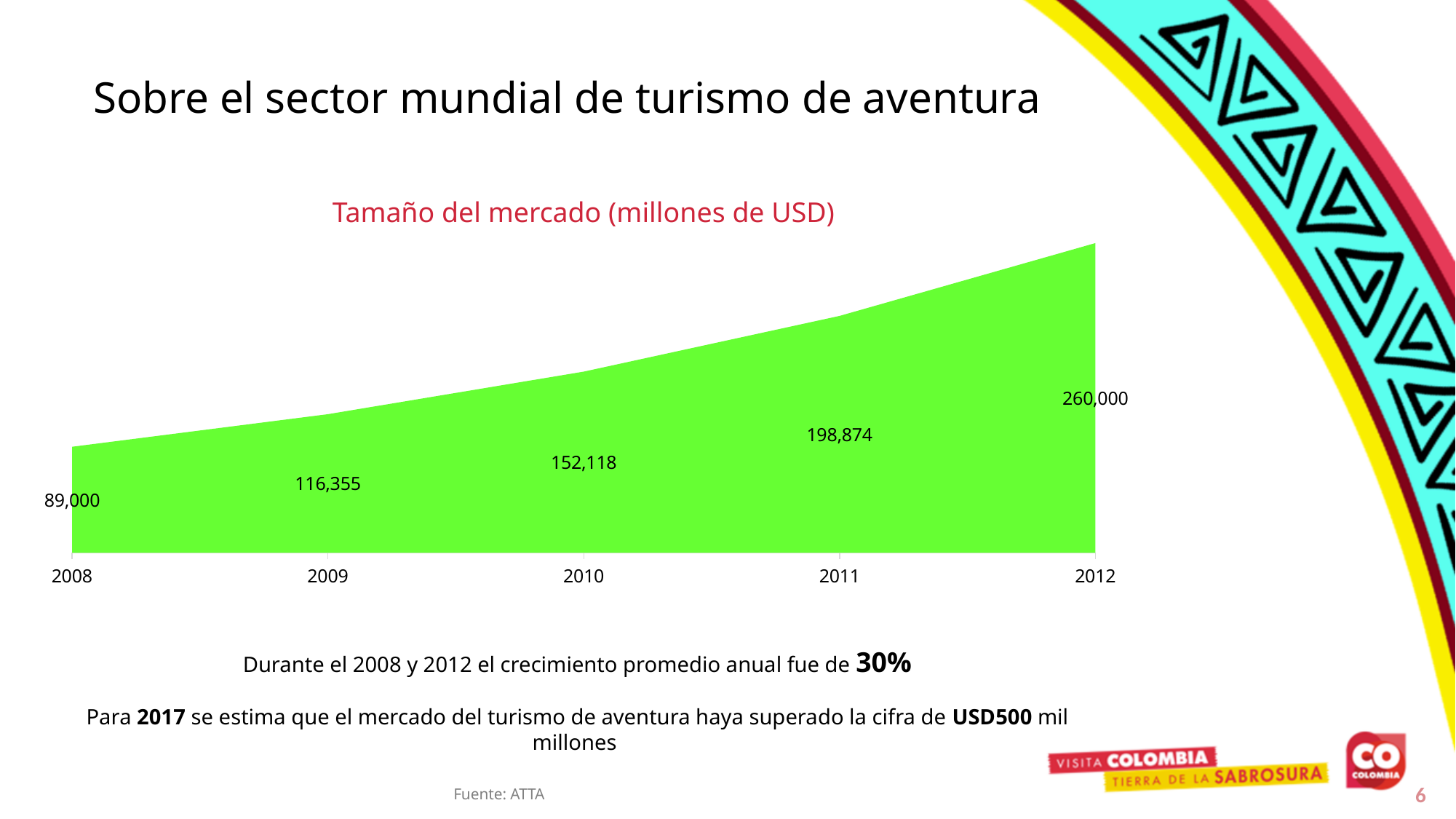
Do the values rise or fall from 2008 to 2012? Rise What is the market size value shown for 2011? 198,874 What is the title of the chart? Tamaño del mercado (millones de USD) Which year has the highest market size value? 2012 What is the difference between the 2012 value and the 2008 value? 171,000 What is the market size value shown for 2010? 152,118 What is the market size value shown for 2008? 89,000 Which is larger, the value for 2009 or the value for 2011? 2011 What kind of chart is shown on the slide? Area chart How many years are plotted on the chart? 5 What is the difference between the 2010 value and the 2009 value? 35,763 Which year has the lowest market size value? 2008